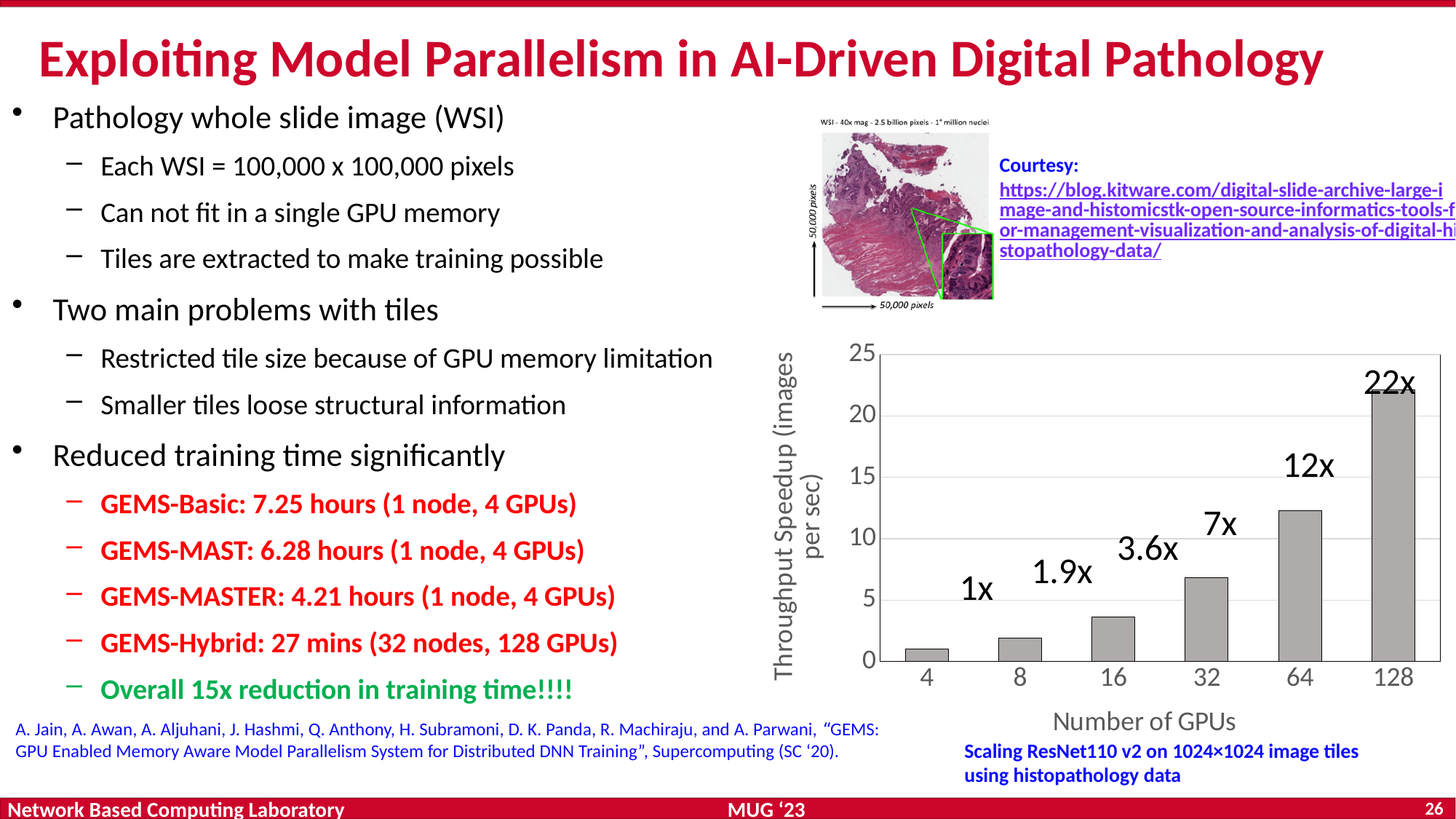
What is the throughput speedup shown for 16 GPUs? 3.6x How many GPU counts are plotted on the x axis of the chart? 6 Which has a larger throughput speedup, 8 GPUs or 32 GPUs? 32 GPUs Is the value for 64 GPUs greater or less than 10? greater What is the throughput speedup shown for 128 GPUs? 22x Which number of GPUs has the highest throughput speedup? 128 What kind of chart is shown on the slide? bar chart What is the label of the y axis of the chart? Throughput Speedup (images per sec) Do the throughput speedup values rise or fall as the number of GPUs increases? rise What is the difference between the speedup at 128 GPUs and the speedup at 64 GPUs? 10x What is the throughput speedup shown for 32 GPUs? 7x Which number of GPUs has the lowest throughput speedup? 4